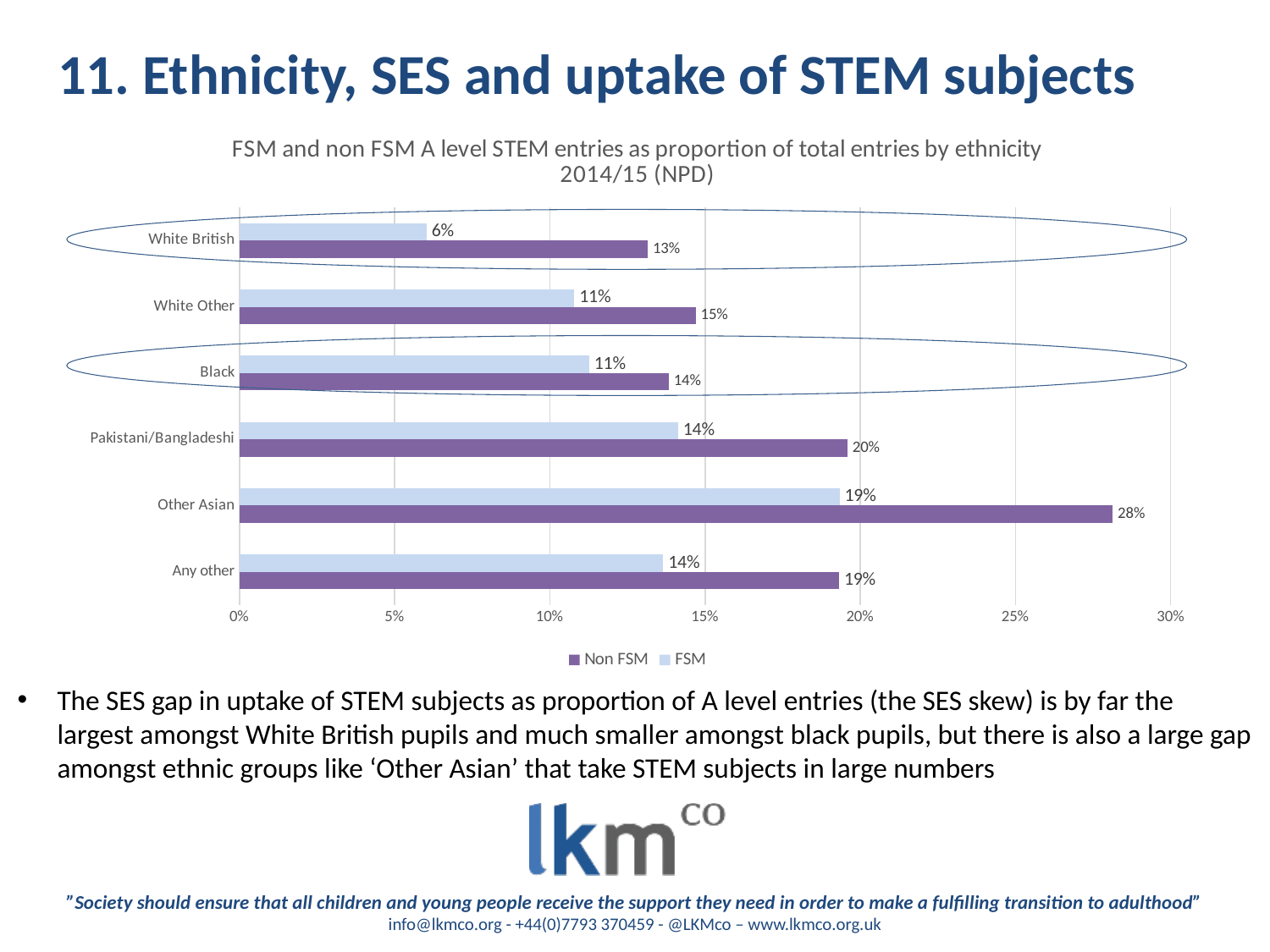
What is the Non FSM value for Other Asian? 28% Which is larger, the Non FSM value for Pakistani/Bangladeshi or the Non FSM value for Black? Pakistani/Bangladeshi What is the FSM value for White British? 6% What is the FSM value for Pakistani/Bangladeshi? 14% What type of chart is shown on the slide? Bar chart Which ethnic group has the highest Non FSM value? Other Asian What is the difference between the Non FSM and FSM values for Other Asian? 9% What is the title of the chart? FSM and non FSM A level STEM entries as proportion of total entries by ethnicity 2014/15 (NPD) How many series does the legend list? 2 How many ethnic groups are shown on the chart? 6 Which ethnic group has the lowest FSM value? White British What is the Non FSM value for White British? 13%